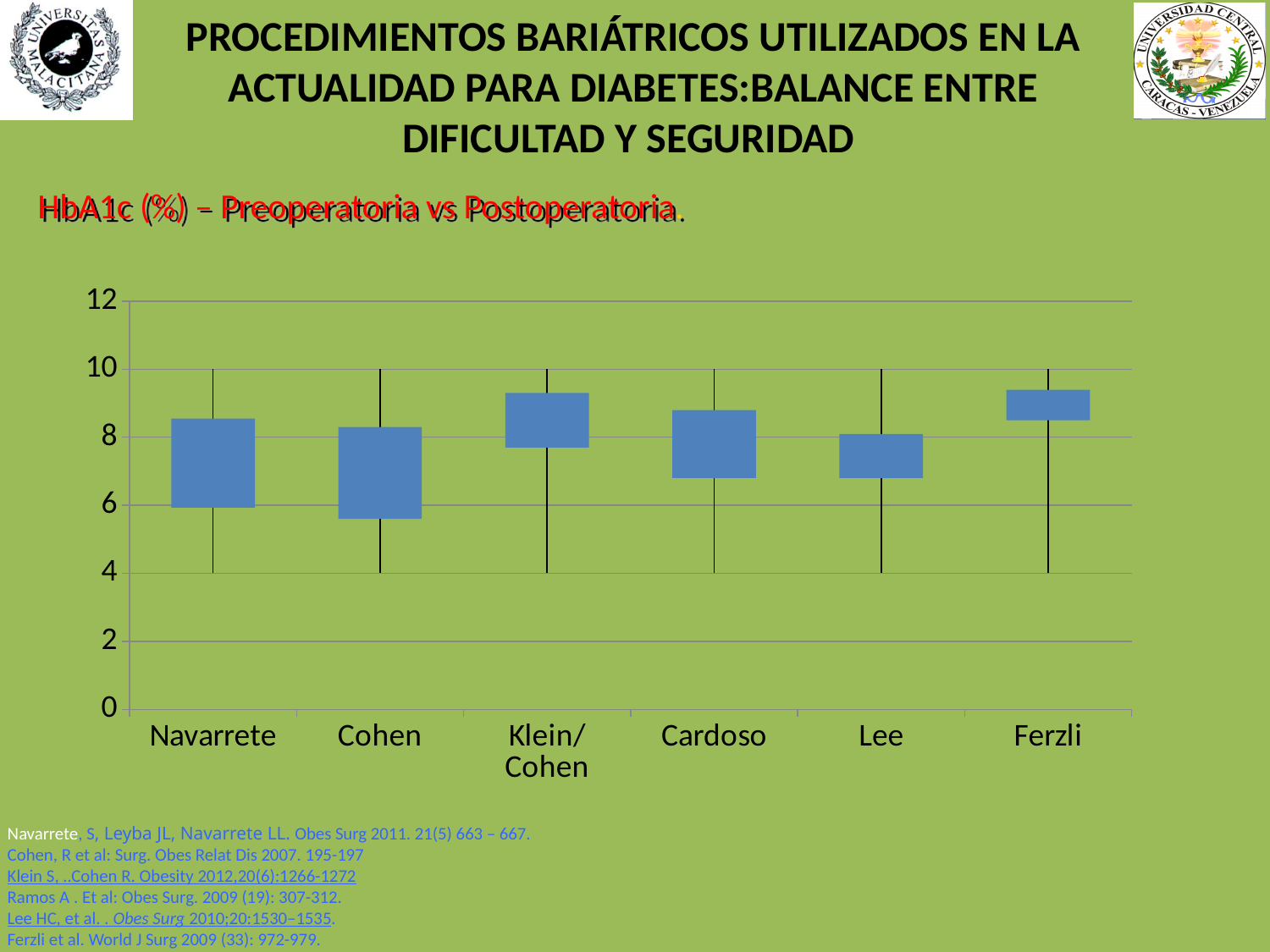
Is the bottom of the box for Ferzli greater or less than 8? greater Is the bottom of the box for Klein/Cohen greater or less than 6? greater Is the top of the box for Navarrete greater or less than 10? less What is the title of the chart? HbA1c (%) – Preoperatoria vs Postoperatoria. Which category has the highest bottom edge of its box? Ferzli How many categories are shown on the x axis of the chart? 6 Is the bottom of the box for Klein/Cohen higher or lower than the bottom of the box for Cohen? higher What is the highest value shown on the y axis of the chart? 12